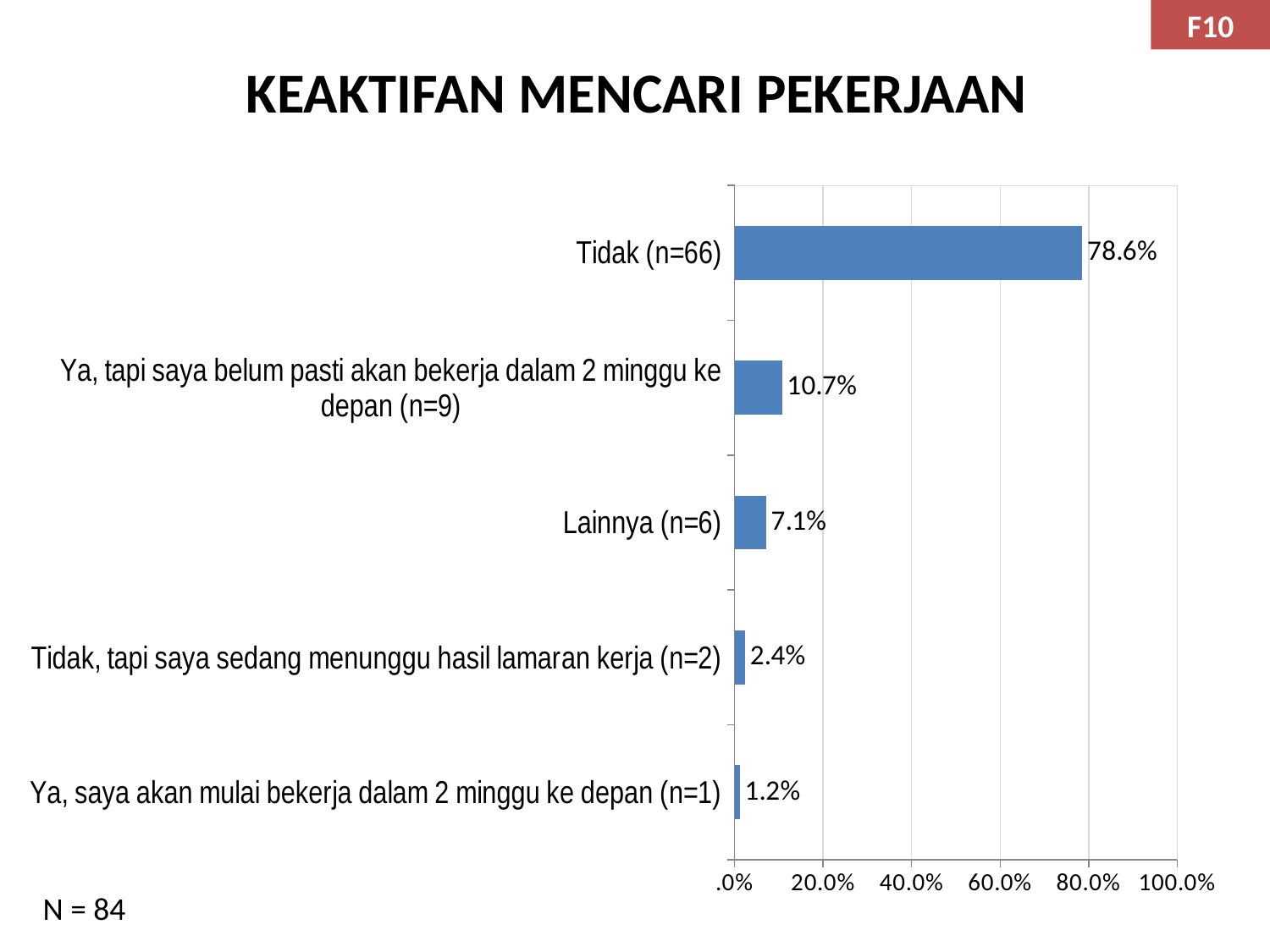
Is the value for "Tidak (n=66)" greater or less than 60.0%? greater Which category has the highest value? Tidak (n=66) What is the difference between the values for "Tidak (n=66)" and "Ya, tapi saya belum pasti akan bekerja dalam 2 minggu ke depan (n=9)"? 67.9% What is the value for "Tidak (n=66)"? 78.6% Which is larger, the value for "Lainnya (n=6)" or the value for "Tidak, tapi saya sedang menunggu hasil lamaran kerja (n=2)"? Lainnya (n=6) What is the value for "Tidak, tapi saya sedang menunggu hasil lamaran kerja (n=2)"? 2.4% Which category has the lowest value? Ya, saya akan mulai bekerja dalam 2 minggu ke depan (n=1) What is the value for "Ya, saya akan mulai bekerja dalam 2 minggu ke depan (n=1)"? 1.2% How many categories are shown in the chart? 5 What kind of chart is shown on the slide? bar chart What is the value for "Lainnya (n=6)"? 7.1% What is the title of the slide? KEAKTIFAN MENCARI PEKERJAAN